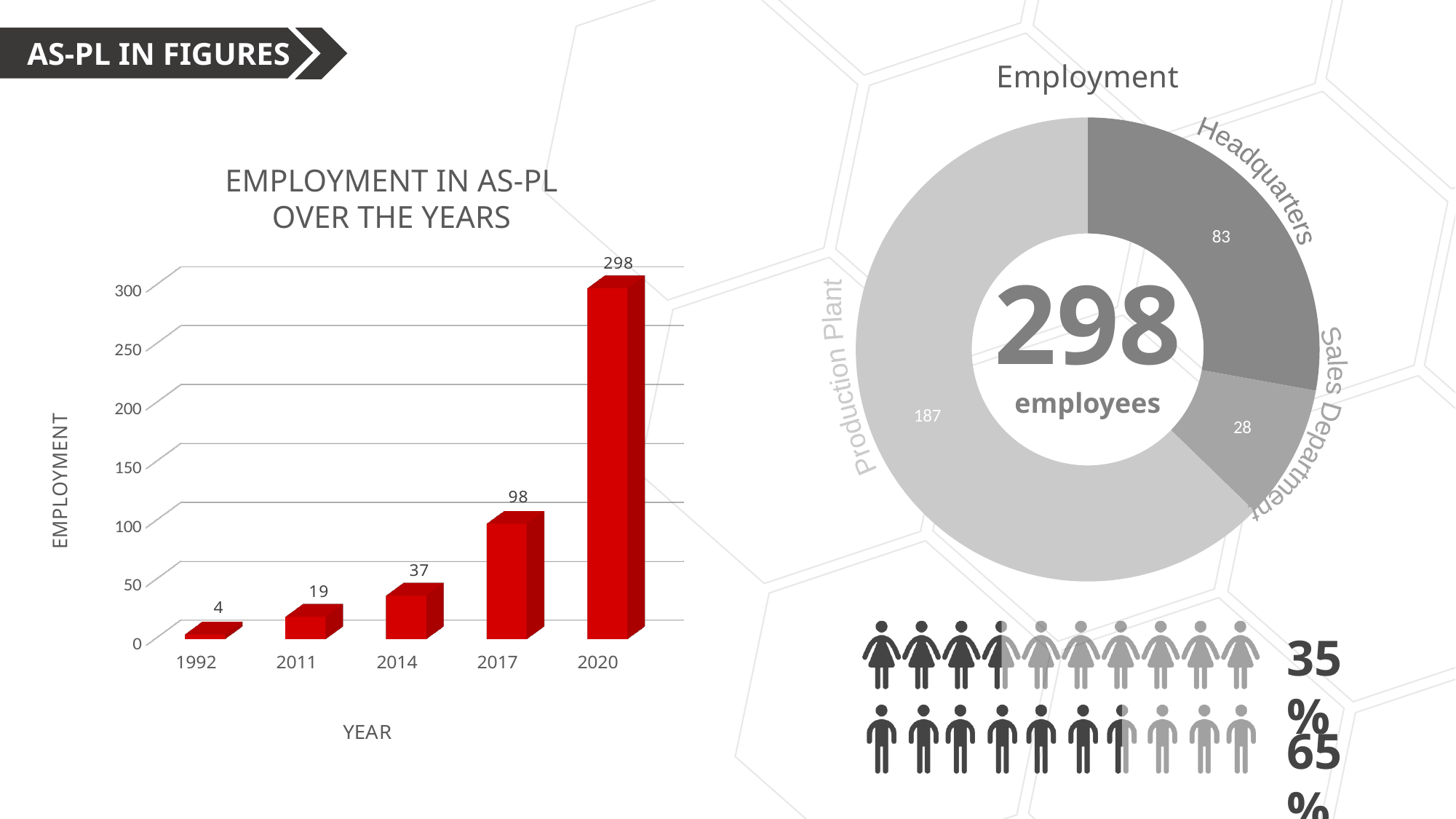
What kind of chart is 'Employment in AS-PL over the years'? Bar chart In the 'Employment in AS-PL over the years' chart, what is the difference in employment between 2020 and 2017? 200 In the 'Employment' doughnut chart, which segment is larger: Headquarters or Sales Department? Headquarters In the 'Employment in AS-PL over the years' chart, which year has the lowest employment? 1992 In the 'Employment in AS-PL over the years' chart, what was employment in 1992? 4 In the 'Employment' doughnut chart, how many employees are in the Production Plant? 187 In the 'Employment in AS-PL over the years' chart, what was employment in 2017? 98 In the 'Employment in AS-PL over the years' chart, does employment rise or fall from 1992 to 2020? Rises In the 'Employment in AS-PL over the years' chart, how many years are shown on the x axis? 5 In the 'Employment in AS-PL over the years' chart, which year has the highest employment? 2020 In the 'Employment' doughnut chart, how many employees are in the Sales Department? 28 What total number of employees is shown in the centre of the 'Employment' doughnut chart? 298